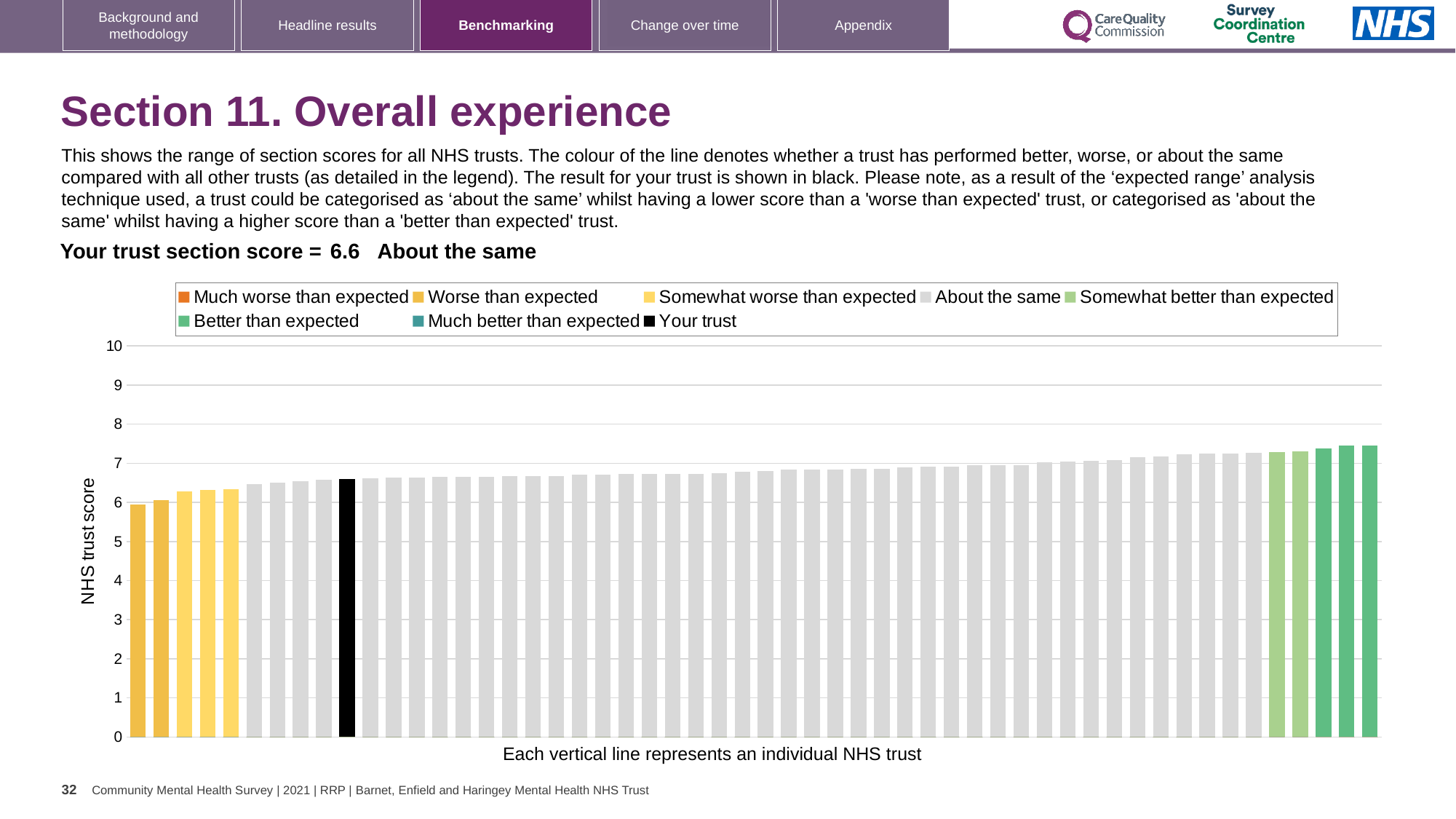
Is the value for your trust (the black bar) greater or less than 5? greater How many yellow bars (worse or somewhat worse than expected) are at the left of the chart? 5 Do the bar values rise or fall from left to right along the x axis? rise What colour is used for the bar representing your trust? black Is the value for your trust (the black bar) greater or less than 7? less What kind of chart is shown on the slide? bar chart What is the label on the vertical axis of the chart? NHS trust score How many entries does the chart legend list? 8 How is your trust categorised compared with other trusts? About the same Is the value of the lowest bar in the chart greater or less than 5? greater What is the section score for your trust shown on the slide? 6.6